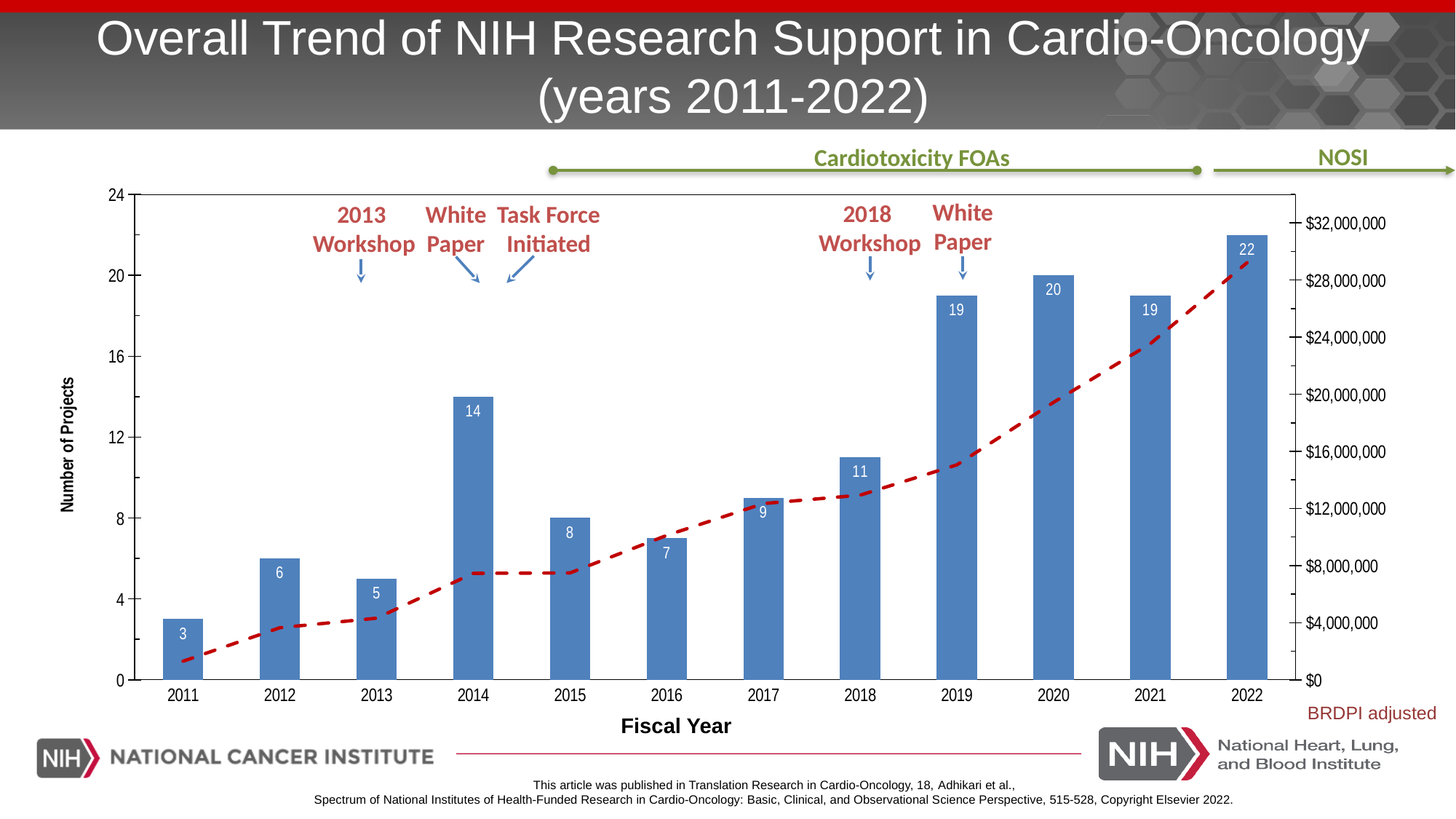
Which fiscal year had more projects, 2018 or 2020? 2020 What is the difference in the number of projects between 2022 and 2011? 19 How many fiscal years are plotted on the x axis? 12 What is the number of projects shown for fiscal year 2019? 19 Is the dashed-line funding value for 2011 greater or less than $4,000,000? less How many projects were funded in fiscal year 2014? 14 What is the label of the left vertical axis? Number of Projects What kind of chart is used to show the number of projects? bar chart Which fiscal year had more projects, 2015 or 2016? 2015 Which fiscal year has the lowest number of projects? 2011 How many more projects were there in 2014 than in 2013? 9 Which fiscal year has the highest number of projects? 2022